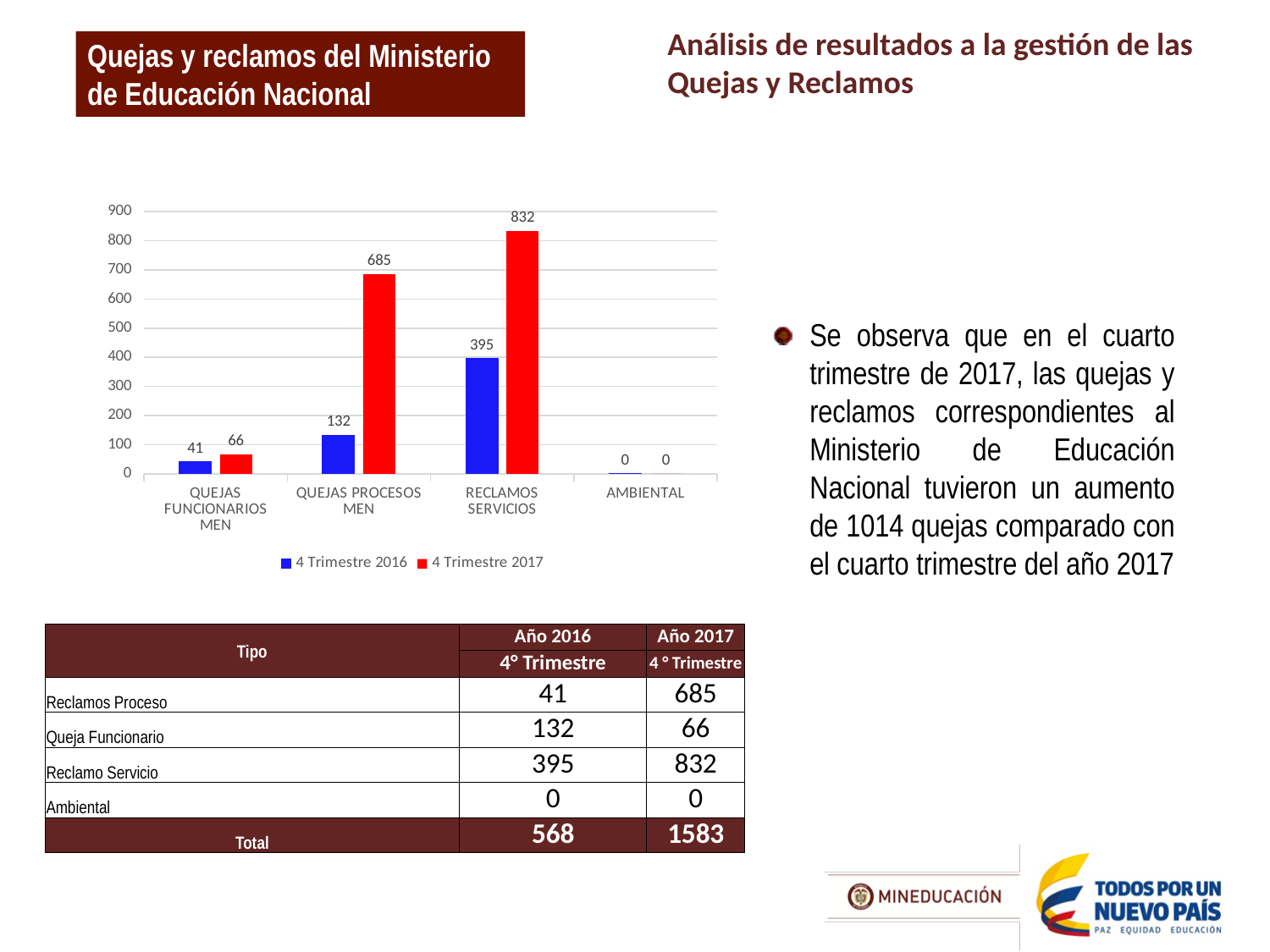
What colour represents the 4 Trimestre 2017 series in the chart? red How many categories are shown on the x axis of the chart? 4 What type of chart is shown on the slide? bar chart What is the difference between the 4 Trimestre 2017 and 4 Trimestre 2016 values for QUEJAS PROCESOS MEN? 553 Which category has the highest value in the 4 Trimestre 2017 series? RECLAMOS SERVICIOS What is the value for QUEJAS PROCESOS MEN in the 4 Trimestre 2017 series? 685 What is the difference between the 4 Trimestre 2017 and 4 Trimestre 2016 values for RECLAMOS SERVICIOS? 437 Which category has the lowest value in the 4 Trimestre 2016 series? AMBIENTAL What is the value for RECLAMOS SERVICIOS in the 4 Trimestre 2016 series? 395 Which is larger for QUEJAS FUNCIONARIOS MEN: the 4 Trimestre 2016 value or the 4 Trimestre 2017 value? 4 Trimestre 2017 What is the value for QUEJAS FUNCIONARIOS MEN in the 4 Trimestre 2016 series? 41 How many series does the chart legend list? 2